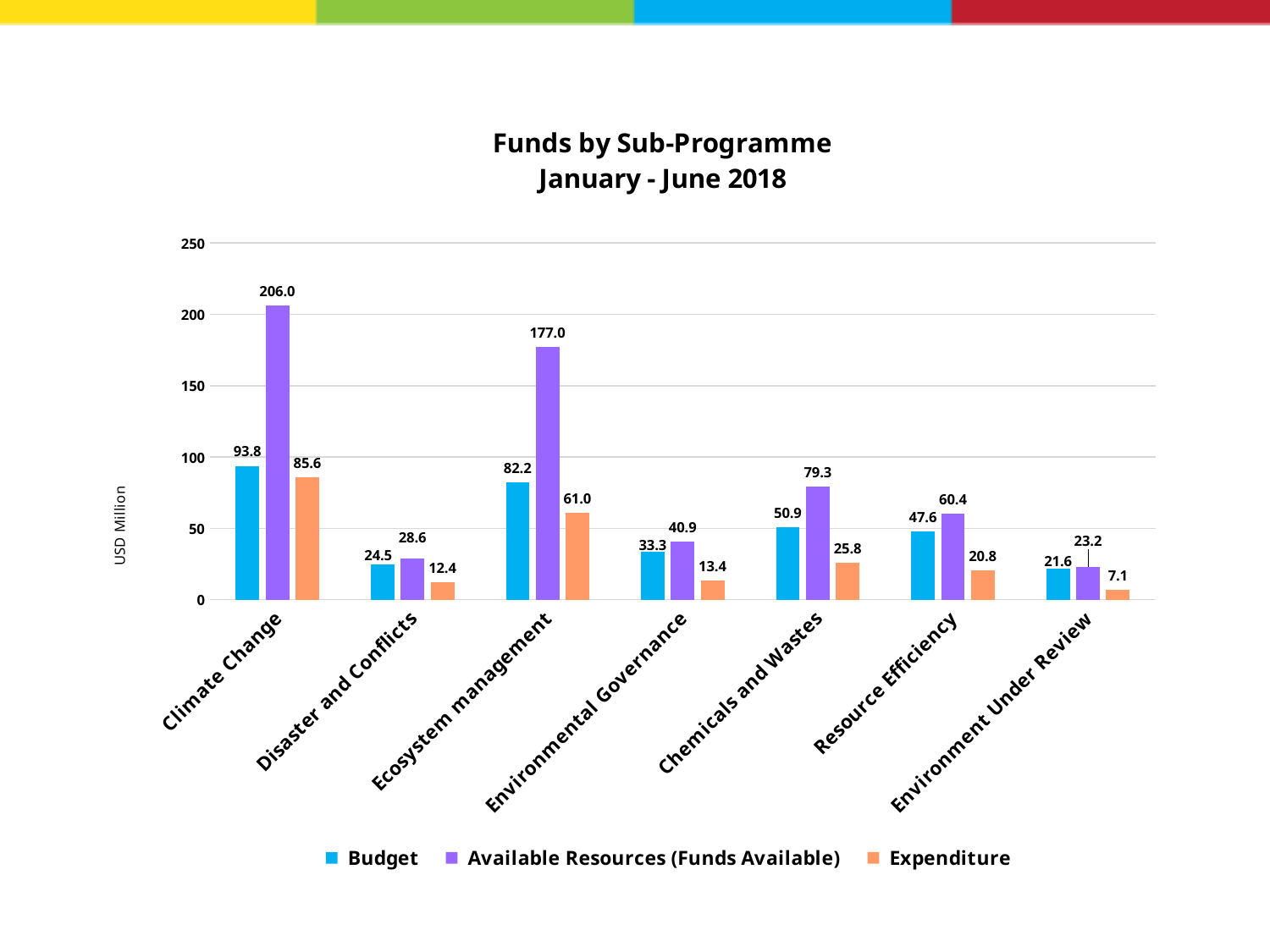
Which sub-programme has the lowest Expenditure value? Environment Under Review What is the label of the vertical axis? USD Million Which is larger for Resource Efficiency: the Budget value or the Available Resources (Funds Available) value? Available Resources (Funds Available) Is the Available Resources (Funds Available) value for Ecosystem management greater or less than 150? greater What is the Available Resources (Funds Available) value for Ecosystem management? 177.0 What is the Budget value for Climate Change? 93.8 How many series does the legend list? 3 What is the difference between the Available Resources (Funds Available) and Budget values for Climate Change? 112.2 How many sub-programme categories are shown on the x axis? 7 What is the Expenditure value for Chemicals and Wastes? 25.8 Which sub-programme has the highest Available Resources (Funds Available) value? Climate Change What kind of chart is shown on the slide? Bar chart